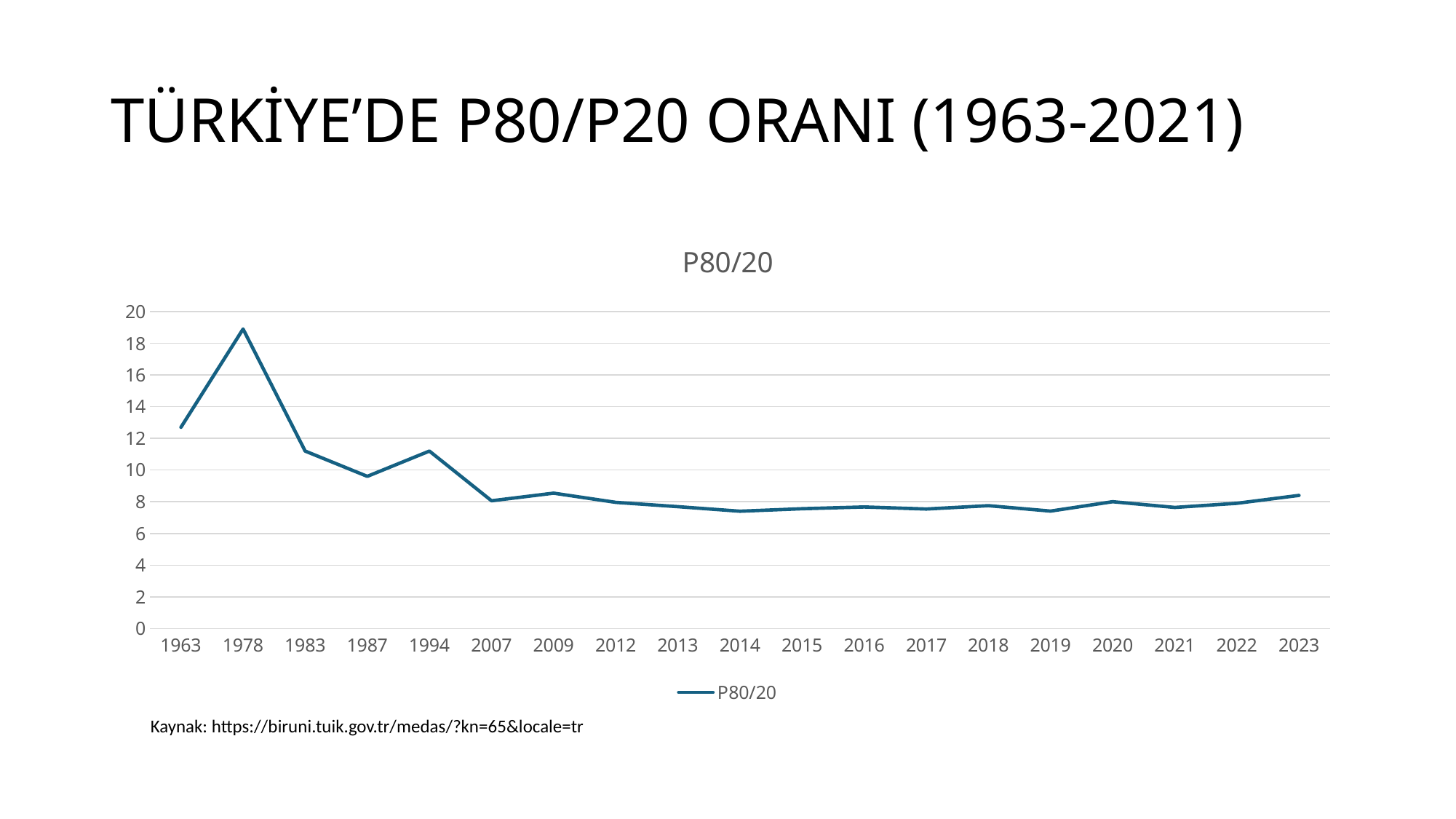
How many years are plotted along the x axis? 19 How many series does the legend list? 1 Which is larger, the value for 1963 or the value for 1983? 1963 Which is larger, the value for 1994 or the value for 1987? 1994 What is the title shown above the chart? P80/20 Is the value for 1987 greater or less than 10? less Does the P80/20 ratio rise or fall from 1978 to 1987? fall Is the value for 2014 greater or less than 8? less Is the value for 1963 greater or less than 12? greater What kind of chart is shown on the slide? line chart In which year is the P80/20 ratio highest? 1978